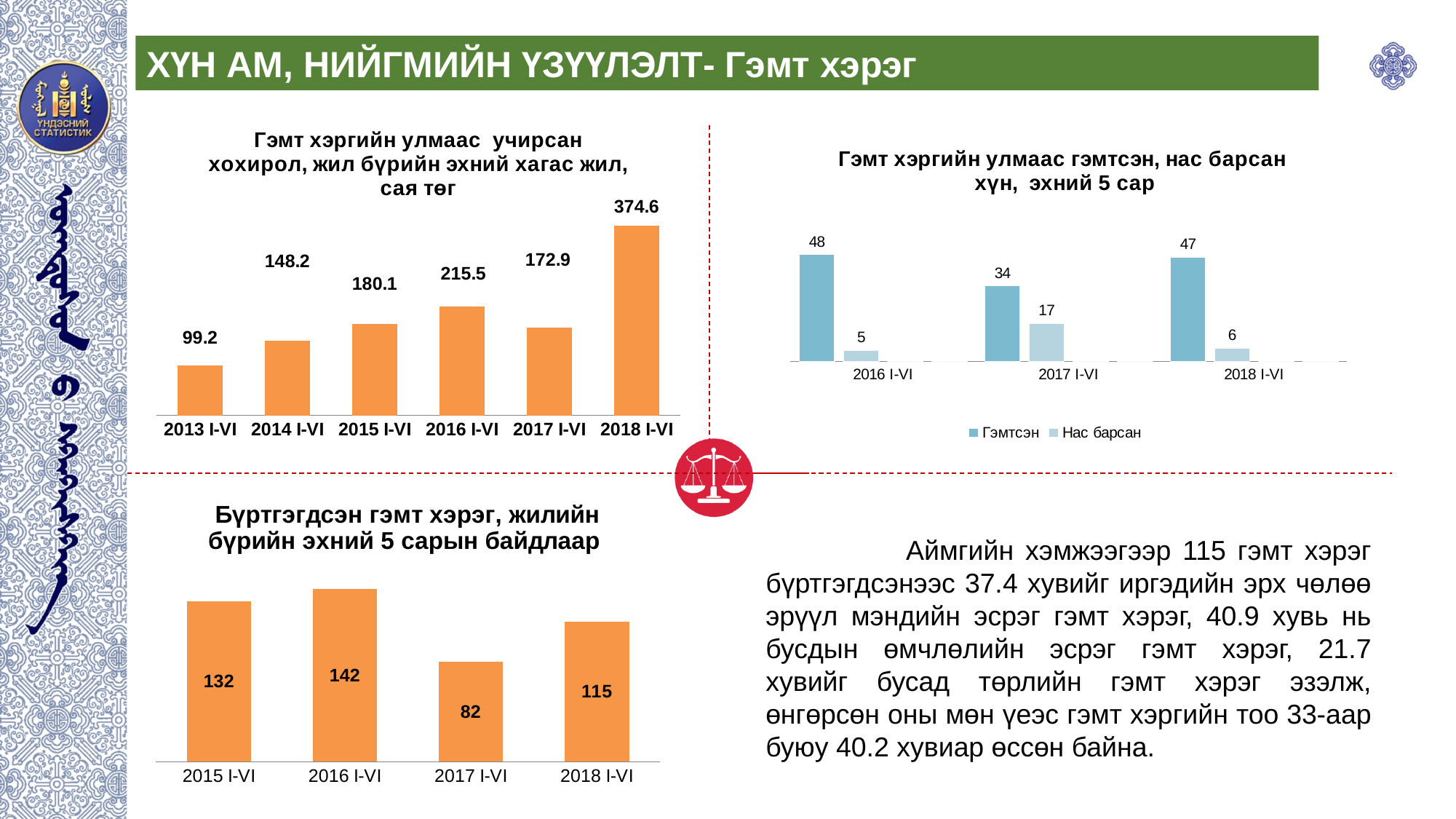
In the bottom-left chart (Бүртгэгдсэн гэмт хэрэг), which is larger, the value for 2015 I-VI or 2018 I-VI? 2015 I-VI In the top-right chart (Гэмт хэргийн улмаас гэмтсэн, нас барсан хүн), what is the Гэмтсэн value for 2017 I-VI? 34 What type of chart is the bottom-left chart (Бүртгэгдсэн гэмт хэрэг)? Bar chart In the top-left chart (Гэмт хэргийн улмаас учирсан хохирол), which period has the highest value? 2018 I-VI In the top-right chart (Гэмт хэргийн улмаас гэмтсэн, нас барсан хүн), which year has the highest Нас барсан value? 2017 I-VI In the top-left chart (Гэмт хэргийн улмаас учирсан хохирол), how many periods are shown? 6 In the top-right chart (Гэмт хэргийн улмаас гэмтсэн, нас барсан хүн), how many series does the legend list? 2 In the top-left chart (Гэмт хэргийн улмаас учирсан хохирол), what is the value for 2016 I-VI? 215.5 In the top-right chart (Гэмт хэргийн улмаас гэмтсэн, нас барсан хүн), what is the Нас барсан value for 2018 I-VI? 6 In the bottom-left chart (Бүртгэгдсэн гэмт хэрэг), what is the value for 2017 I-VI? 82 In the top-left chart (Гэмт хэргийн улмаас учирсан хохирол), which period has the lowest value? 2013 I-VI In the top-left chart (Гэмт хэргийн улмаас учирсан хохирол), what is the difference between the values for 2018 I-VI and 2017 I-VI? 201.7